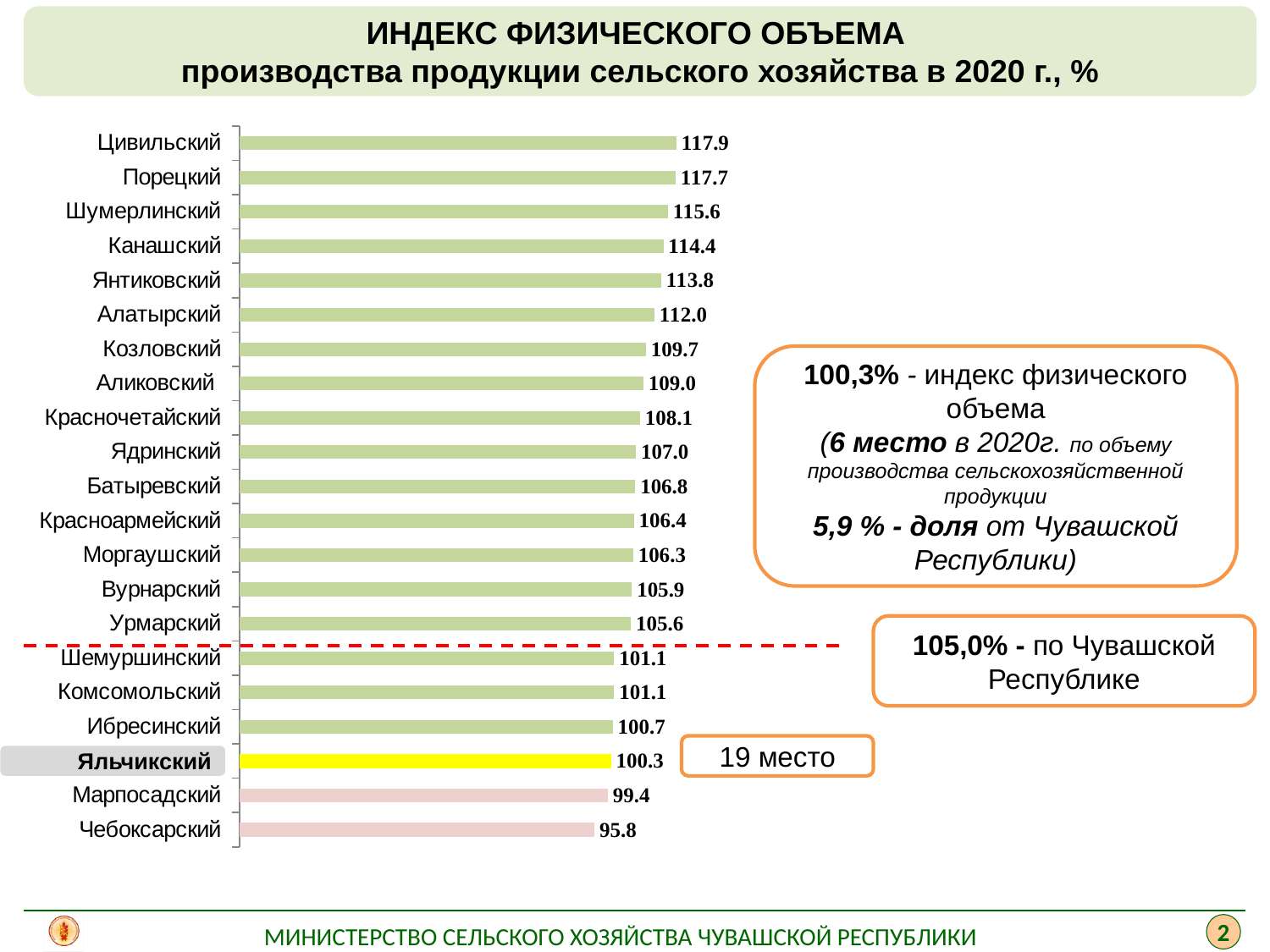
What is the value for Яльчикский? 100.3 What is the difference between the values for Канашский and Янтиковский? 0.6 Which is larger, the value for Козловский or the value for Ядринский? Козловский What is the difference between the values for Цивильский and Чебоксарский? 22.1 What is the value for Цивильский? 117.9 What kind of chart is shown on the slide? bar chart Which district has the lowest value? Чебоксарский Which district has the highest value? Цивильский How many districts are shown in the chart? 21 Which district's bar is highlighted in yellow? Яльчикский What is the value for Чебоксарский? 95.8 What is the value for Алатырский? 112.0